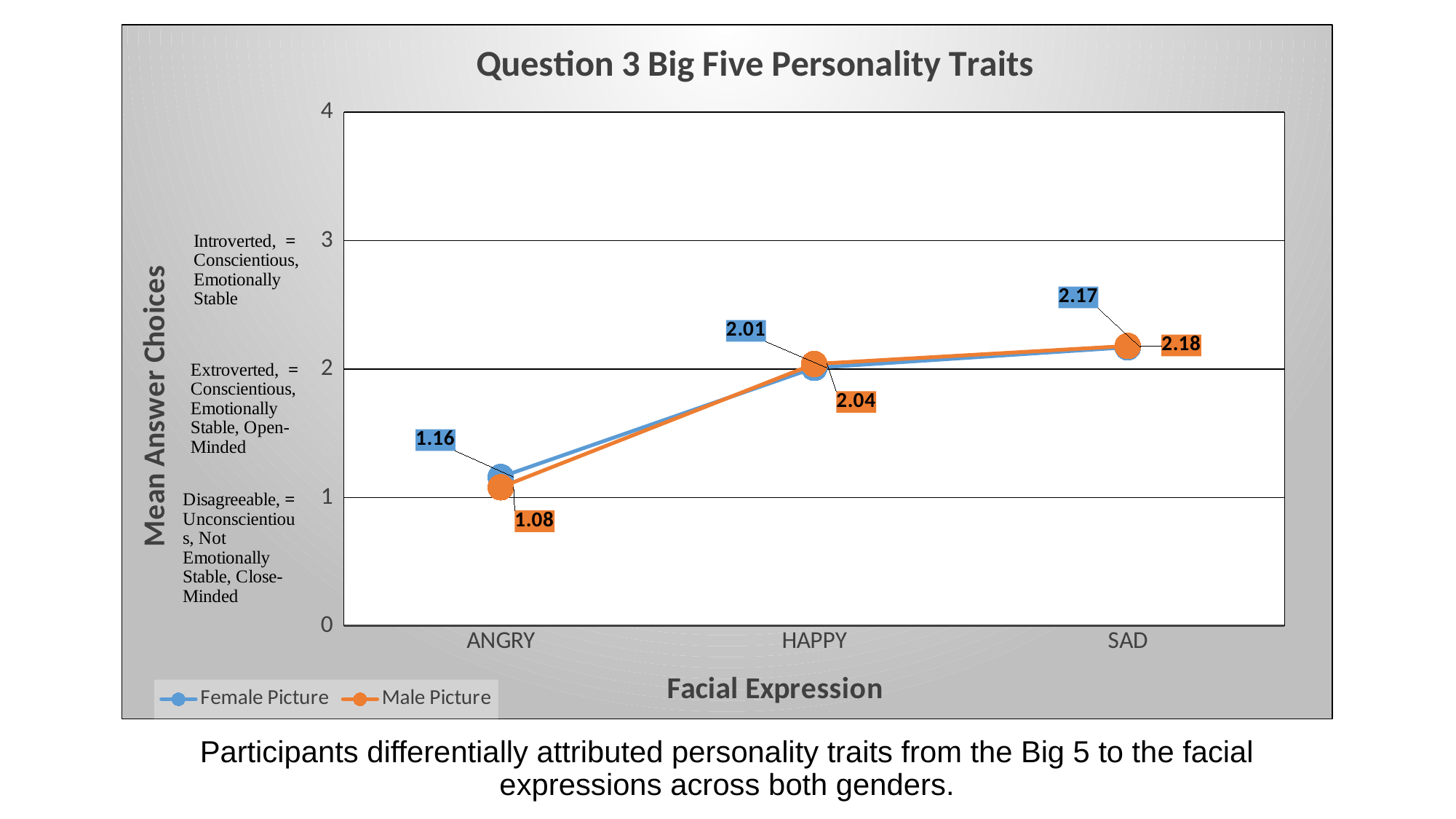
Which is larger for ANGRY, the Female Picture value or the Male Picture value? Female Picture Is the Female Picture value for HAPPY greater or less than 3? less What is the Female Picture value for ANGRY? 1.16 How many series does the legend list? 2 What kind of chart is shown? line chart Which facial expression has the highest Female Picture value? SAD What is the Male Picture value for SAD? 2.18 How many facial expression categories are shown on the x axis? 3 Which facial expression has the lowest Male Picture value? ANGRY What is the difference between the Female Picture and Male Picture values for ANGRY? 0.08 Do the Male Picture values rise or fall from ANGRY to SAD? rise What is the Male Picture value for HAPPY? 2.04